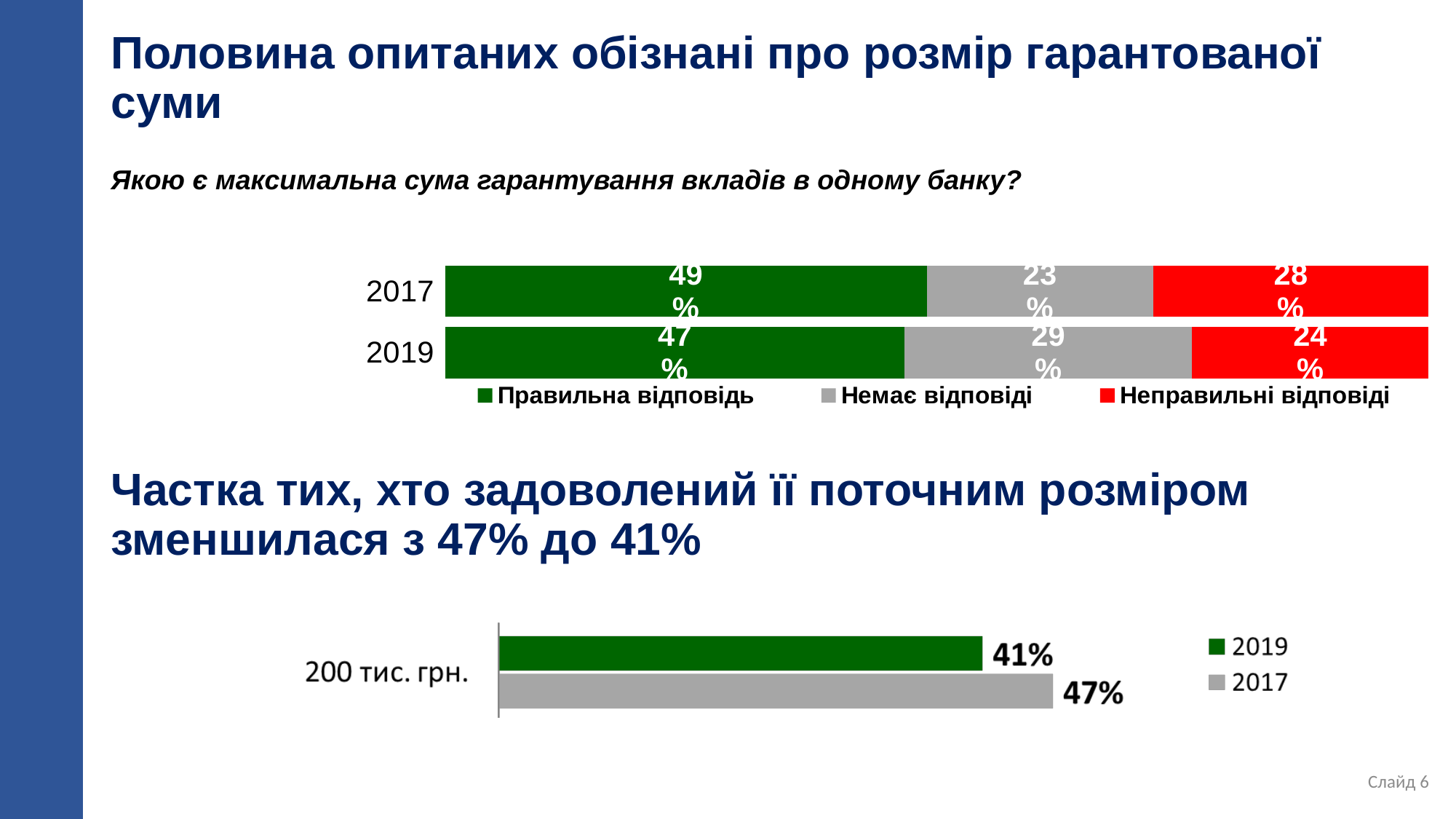
In the bottom chart, what is the difference between the 2017 and 2019 values? 6% In the top chart, which year has the higher share of incorrect answers (Неправильні відповіді), 2017 or 2019? 2017 In the top chart, what is the total of the stacked bar for 2019? 100% In the bottom chart, what is the value for 2019? 41% In the top chart, what percentage of respondents gave no answer (Немає відповіді) in 2019? 29% In the top chart, how many series does the legend list? 3 In the top chart, what percentage of respondents gave incorrect answers (Неправильні відповіді) in 2017? 28% In the bottom chart, what is the value for 2017? 47% In the top chart, what percentage of respondents gave the correct answer (Правильна відповідь) in 2017? 49% In the top chart, which series has the largest share in 2019? Правильна відповідь What kind of chart is the bottom chart? Bar chart In the top chart, what is the difference between the share of no answers (Немає відповіді) in 2019 and in 2017? 6%